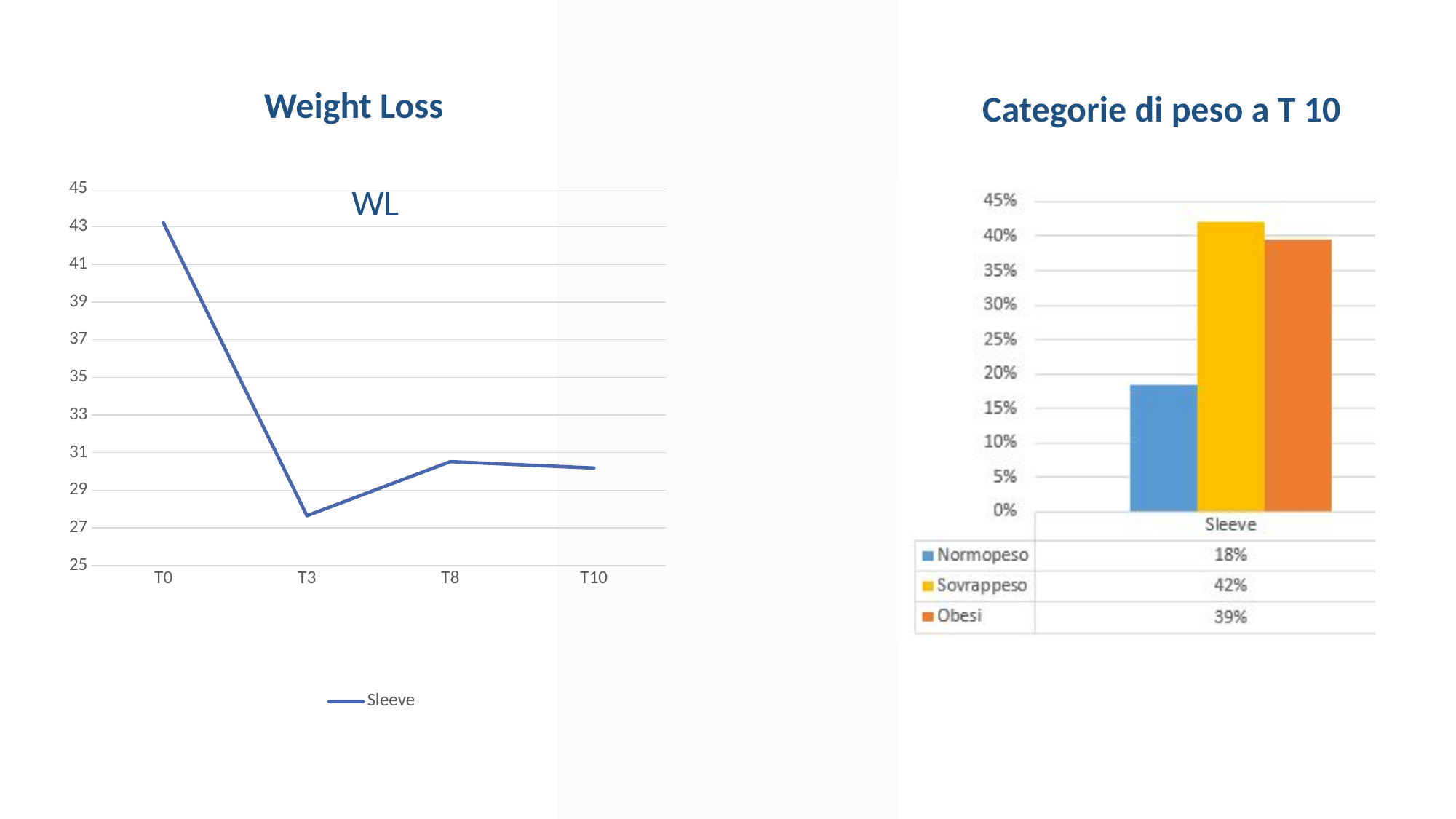
In the 'Categorie di peso a T 10' chart, what is the value for Obesi? 39% How many series does the legend of the 'Categorie di peso a T 10' chart list? 3 In the 'Categorie di peso a T 10' chart, which category has the lowest value? Normopeso What kind of chart is the 'Categorie di peso a T 10' chart? Bar chart In the 'Weight Loss' chart, is the Sleeve value at T0 greater or less than 41? greater In the 'Categorie di peso a T 10' chart, which is larger, Sovrappeso or Obesi? Sovrappeso In the 'Categorie di peso a T 10' chart, what is the difference between Sovrappeso and Normopeso? 24% In the 'Categorie di peso a T 10' chart, which category has the highest value? Sovrappeso What kind of chart is the 'Weight Loss' chart? Line chart In the 'Weight Loss' chart, at which time point is the Sleeve value lowest? T3 In the 'Categorie di peso a T 10' chart, what is the value for Sovrappeso? 42% In the 'Categorie di peso a T 10' chart, what is the value for Normopeso? 18%